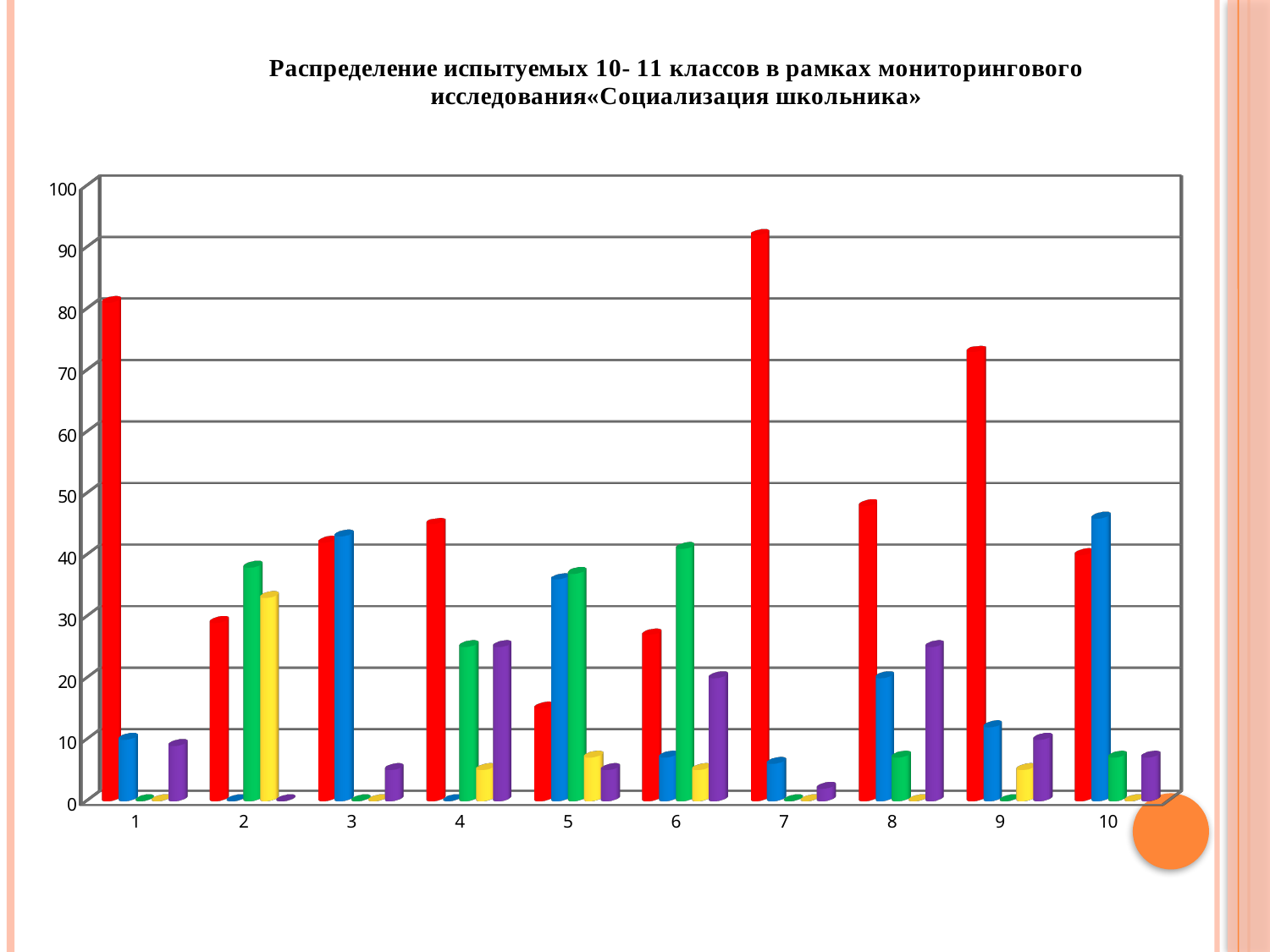
How many categories are shown along the x axis? 10 Which category has the tallest red bar? 7 Is the red bar for category 9 greater or less than 60? greater Which is larger, the red bar for category 1 or the red bar for category 9? category 1 Is the blue bar for category 10 greater or less than 40? greater What kind of chart is shown on the slide? bar chart Which is larger, the green bar for category 6 or the green bar for category 4? category 6 Is the red bar for category 7 greater or less than 80? greater Which category has the shortest red bar? 5 What is the highest value shown on the vertical axis? 100 How many bars are plotted for each category? 5